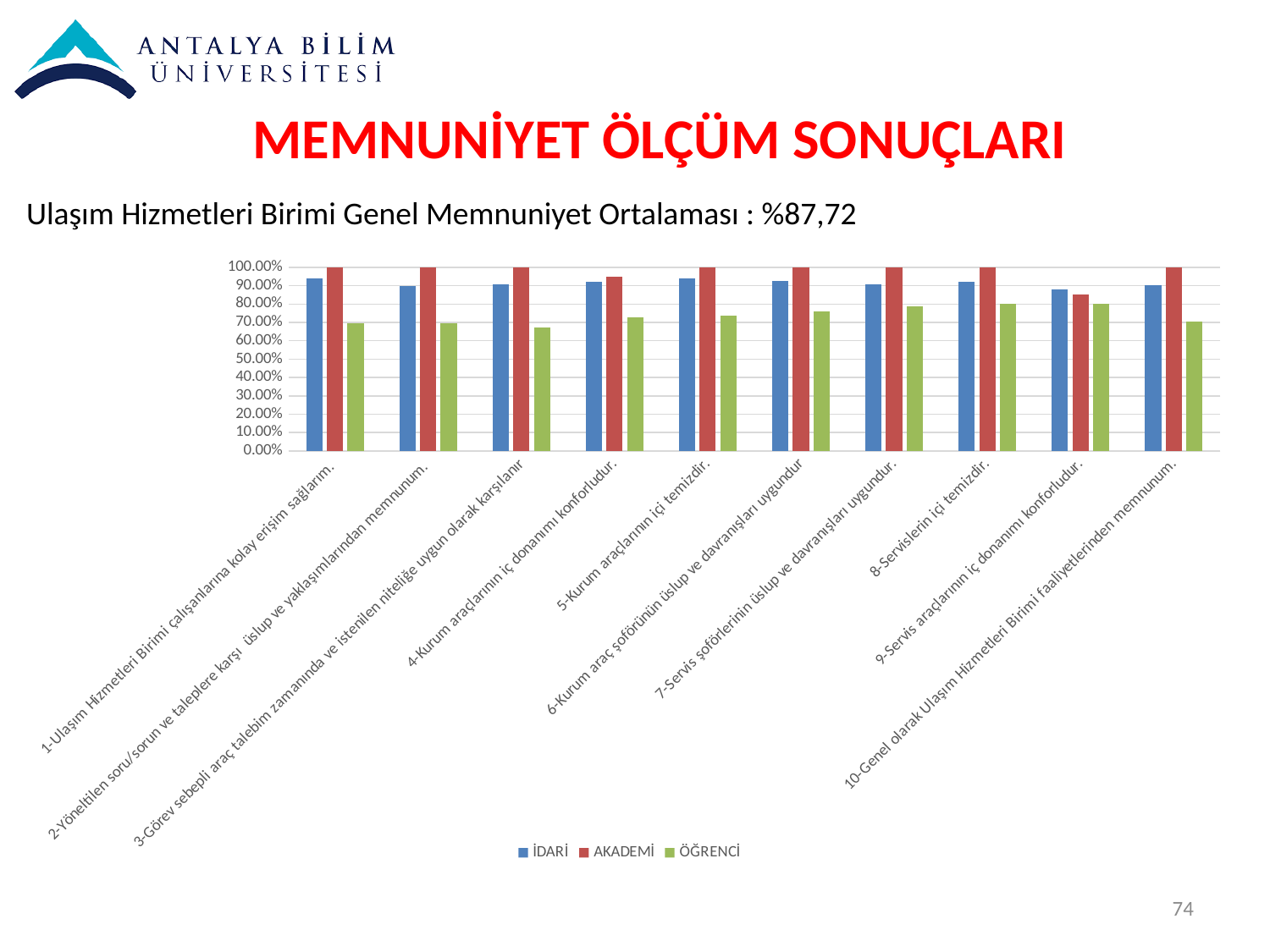
How many series does the legend list? 3 What kind of chart is shown on the slide? bar chart Is the ÖĞRENCİ value for category 3 (Görev sebepli araç talebim zamanında ve istenilen niteliğe uygun olarak karşılanır) greater or less than 80.00%? less For category 5 (Kurum araçlarının içi temizdir), which series has the lowest value? ÖĞRENCİ What is the AKADEMİ value for category 1 (Ulaşım Hizmetleri Birimi çalışanlarına kolay erişim sağlarım)? 100.00% How many categories are shown on the x axis of the chart? 10 Which series is shown in red in the chart? AKADEMİ For category 6 (Kurum araç şoförünün üslup ve davranışları uygundur), which series has the highest value? AKADEMİ For category 1 (Ulaşım Hizmetleri Birimi çalışanlarına kolay erişim sağlarım), which is larger: the İDARİ value or the ÖĞRENCİ value? İDARİ What are the three series listed in the legend? İDARİ, AKADEMİ, ÖĞRENCİ Is the İDARİ value for category 1 (Ulaşım Hizmetleri Birimi çalışanlarına kolay erişim sağlarım) greater or less than 90.00%? greater Is the AKADEMİ value for category 9 (Servis araçlarının iç donanımı konforludur) greater or less than 90.00%? less